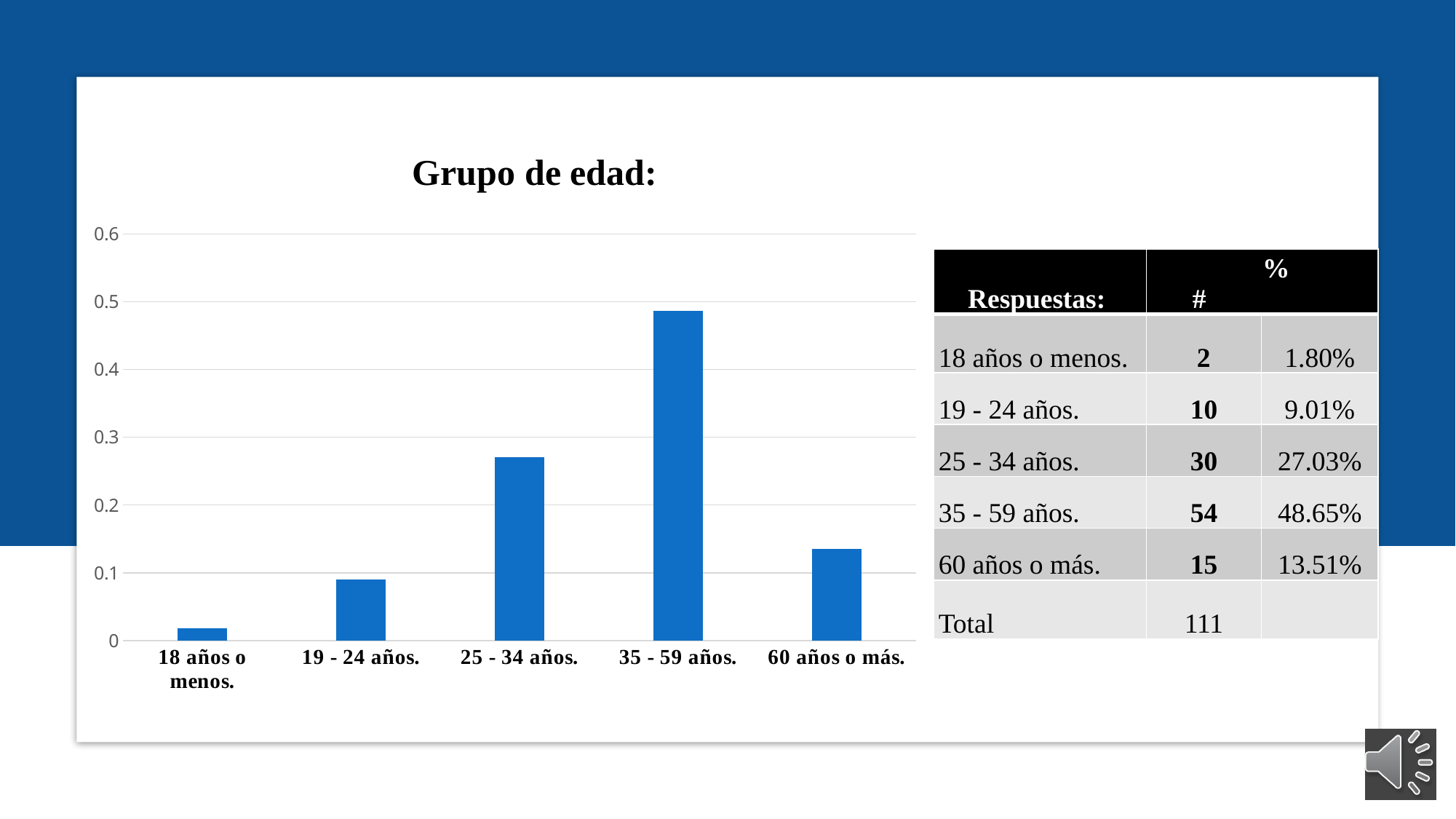
Which age group has the lowest bar in the chart? 18 años o menos. What is the title of the chart? Grupo de edad: Is the value for 25 - 34 años. greater or less than 0.3? less According to the table next to the chart, what percentage corresponds to 35 - 59 años.? 48.65% How many age-group categories does the chart show? 5 Is the value for 19 - 24 años. greater or less than 0.1? less What kind of chart is shown on the slide? bar chart Which age group has the highest bar in the chart? 35 - 59 años. Is the value for 60 años o más. greater or less than 0.1? greater Which is larger, the bar for 25 - 34 años. or the bar for 60 años o más.? 25 - 34 años. According to the table next to the chart, how many responses (#) are in the 25 - 34 años. group? 30